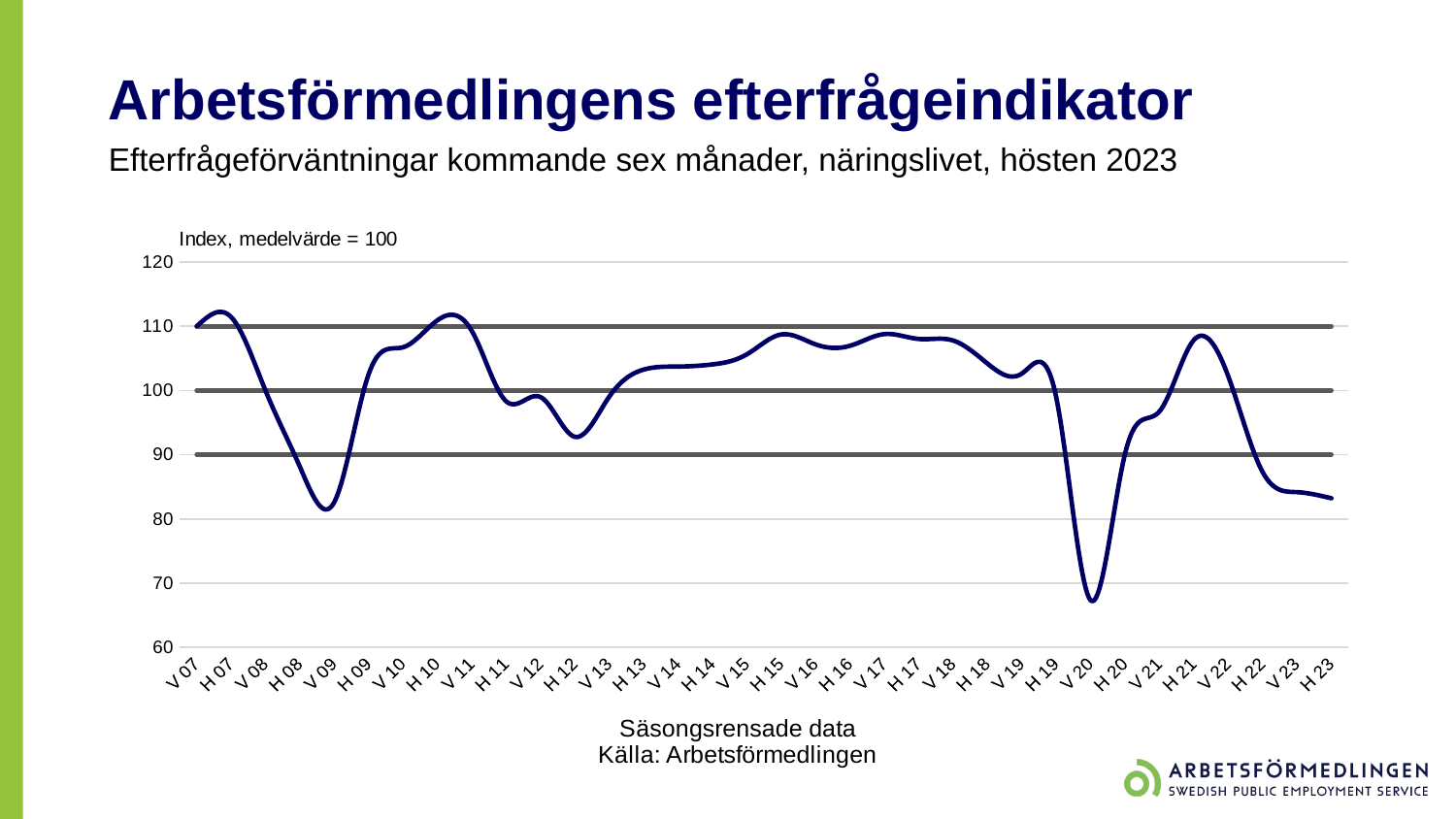
What is the label shown above the y axis? Index, medelvärde = 100 Is the value for H 12 greater or less than 100? less Is the value for H 23 greater or less than 90? less How many periods are labelled on the x axis? 34 Which period has the lowest value on the chart? V 20 Is the value for V 20 greater or less than 70? less What kind of chart is shown on the slide? line chart Does the line rise or fall from H 21 to H 23? fall Which is lower, the value for V 09 or the value for V 20? V 20